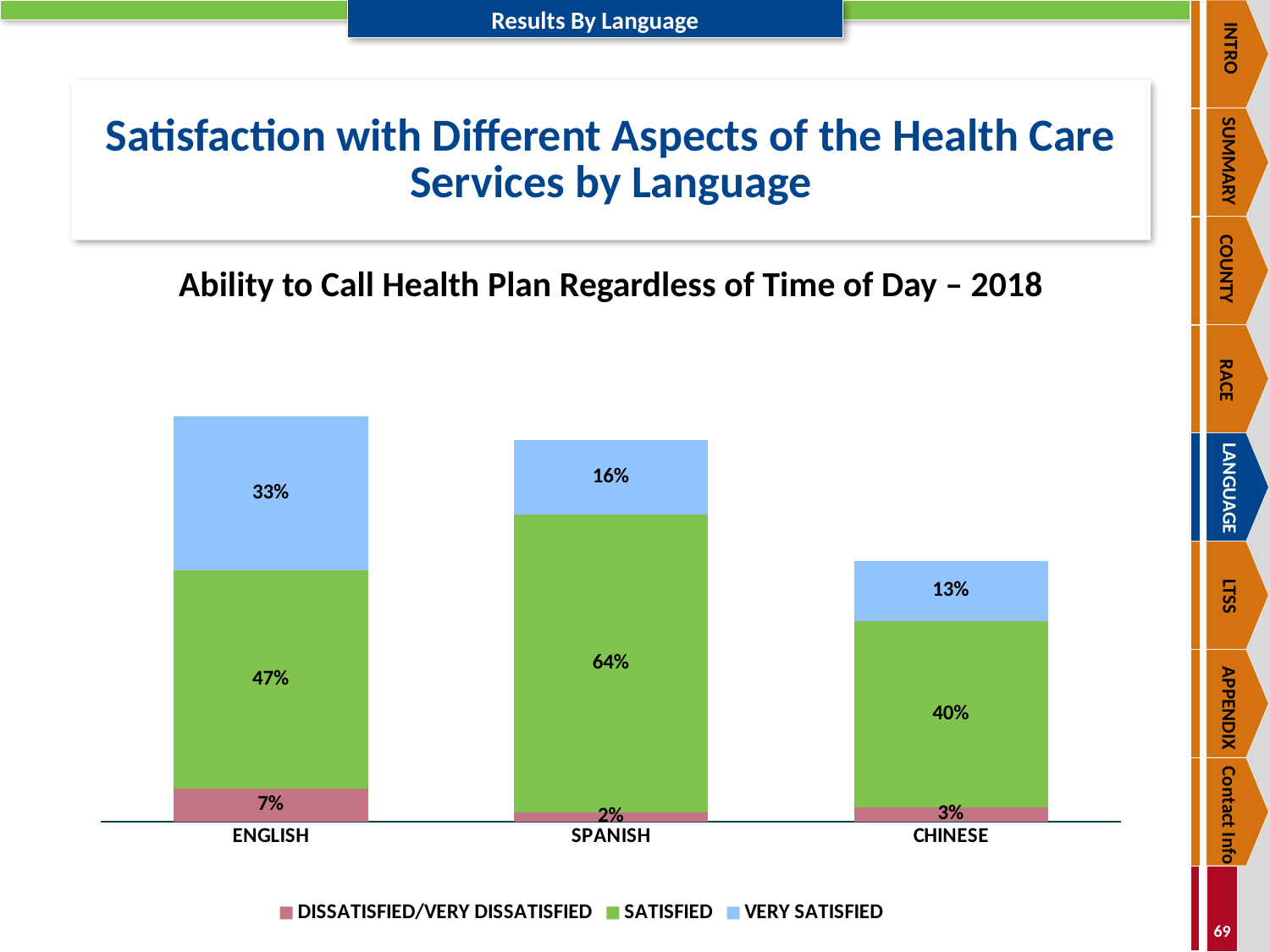
What kind of chart is shown on the slide? Stacked bar chart Which language has the lowest Very Satisfied value? Chinese What is the Satisfied value for Spanish? 64% Is the Very Satisfied value larger for English or for Spanish? English What is the title of the chart? Ability to Call Health Plan Regardless of Time of Day – 2018 What is the total of the stacked bar for English? 87% What is the Very Satisfied value for English? 33% What is the Dissatisfied/Very Dissatisfied value for Chinese? 3% What is the difference between the Satisfied values for Spanish and Chinese? 24% Which language has the highest Satisfied value? Spanish How many series does the legend list? 3 How many language categories are shown on the x axis? 3